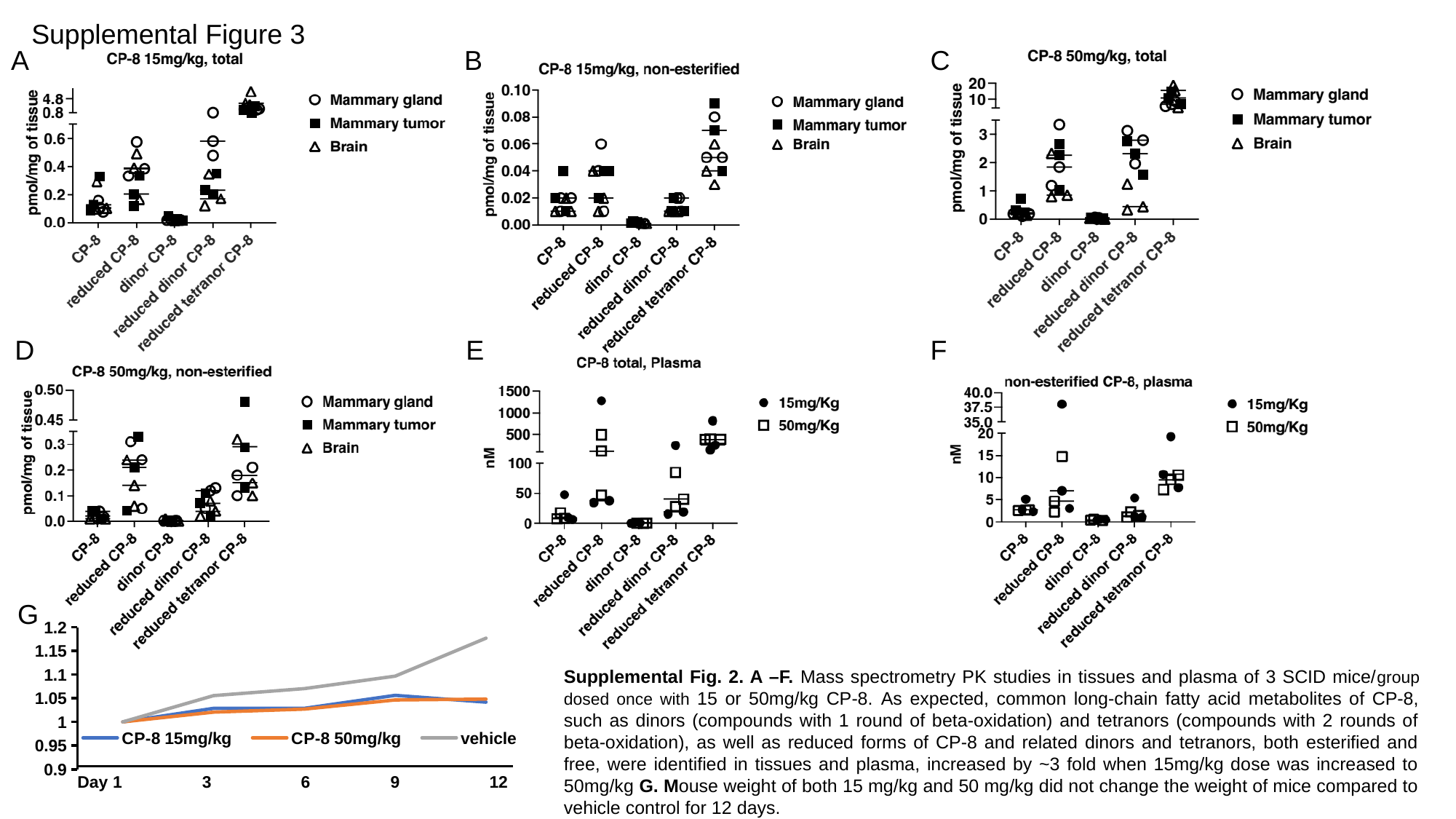
In the chart titled "CP-8 total, Plasma", what unit is shown on the y axis? nM In the chart titled "CP-8 total, Plasma", how many series does the legend list? 2 In the chart titled "CP-8 total, Plasma", are the values for reduced tetranor CP-8 greater or less than 100 nM? greater In the chart titled "CP-8 50mg/kg, total", are the values for reduced tetranor CP-8 greater or less than 3 pmol/mg of tissue? greater In panel G (bottom left), how many series does the legend list? 3 In the chart titled "CP-8 15mg/kg, total", are the values for dinor CP-8 greater or less than 0.2 pmol/mg of tissue? less In the chart titled "CP-8 15mg/kg, total", what are the three legend entries? Mammary gland, Mammary tumor, Brain In panel G (bottom left), does the vehicle line rise or fall from Day 1 to Day 12? rise In the chart titled "CP-8 15mg/kg, total", how many series does the legend list? 3 In panel G (bottom left), which series has the highest value at Day 12? vehicle In the chart titled "CP-8 15mg/kg, total", how many compound categories are shown on the x axis? 5 What kind of chart is panel G (bottom left)? line chart